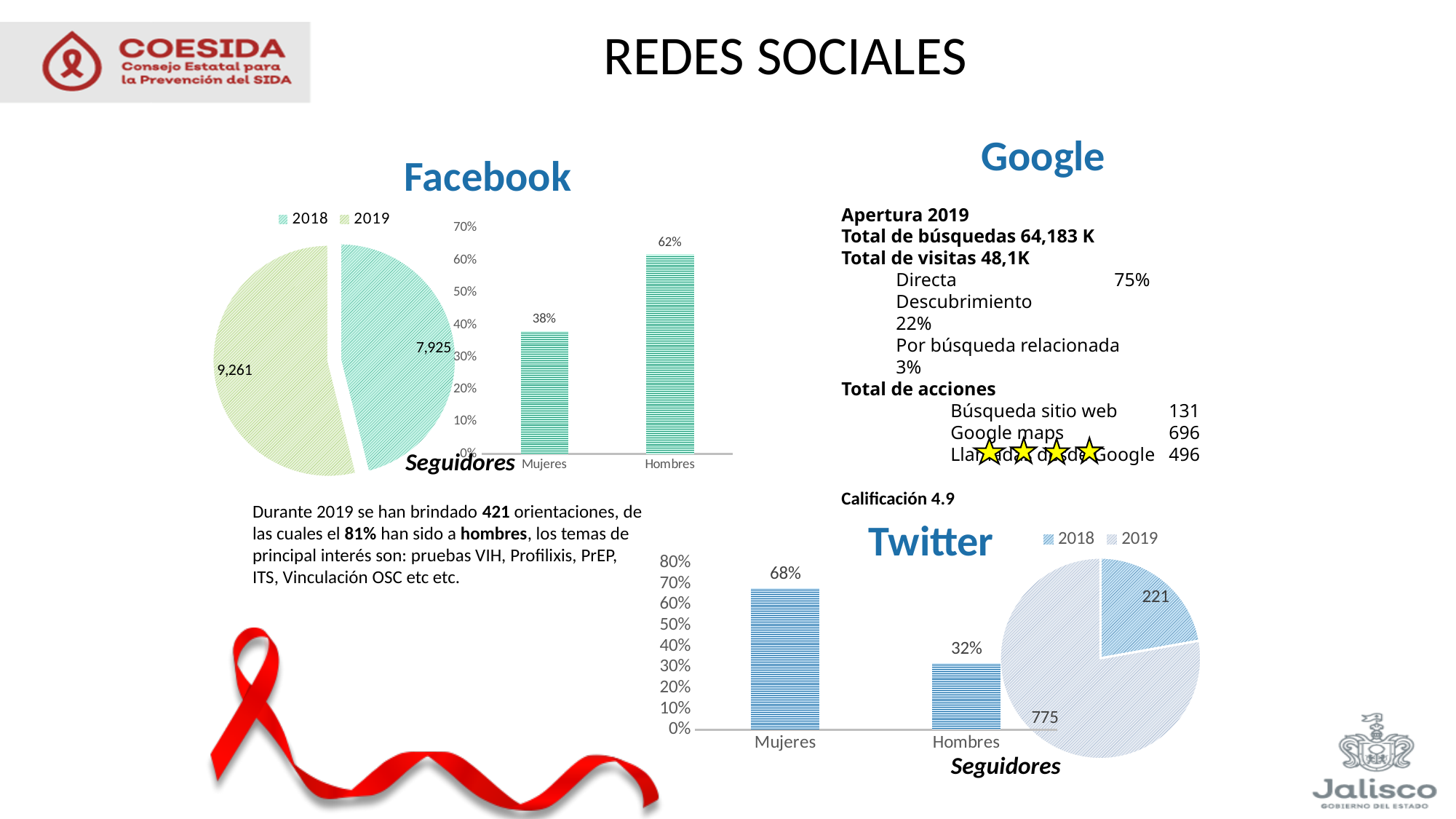
In the Facebook bar chart, what is the value for Mujeres? 38% In the Twitter pie chart, which year has the larger slice, 2018 or 2019? 2019 In the Facebook bar chart, what is the value for Hombres? 62% In the Twitter pie chart, what is the difference between the 2019 and 2018 values? 554 In the Twitter pie chart, what is the value for 2019? 775 In the Twitter bar chart, what is the value for Hombres? 32% In the Facebook pie chart, what is the value for 2019? 9,261 What kind of chart is the Twitter chart showing Mujeres and Hombres? Bar chart In the Facebook bar chart, what is the difference between the Hombres and Mujeres values? 24% How many series does the legend of the Facebook pie chart list? 2 In the Twitter bar chart, which category has the highest value? Mujeres In the Facebook pie chart, what is the value for 2018? 7,925